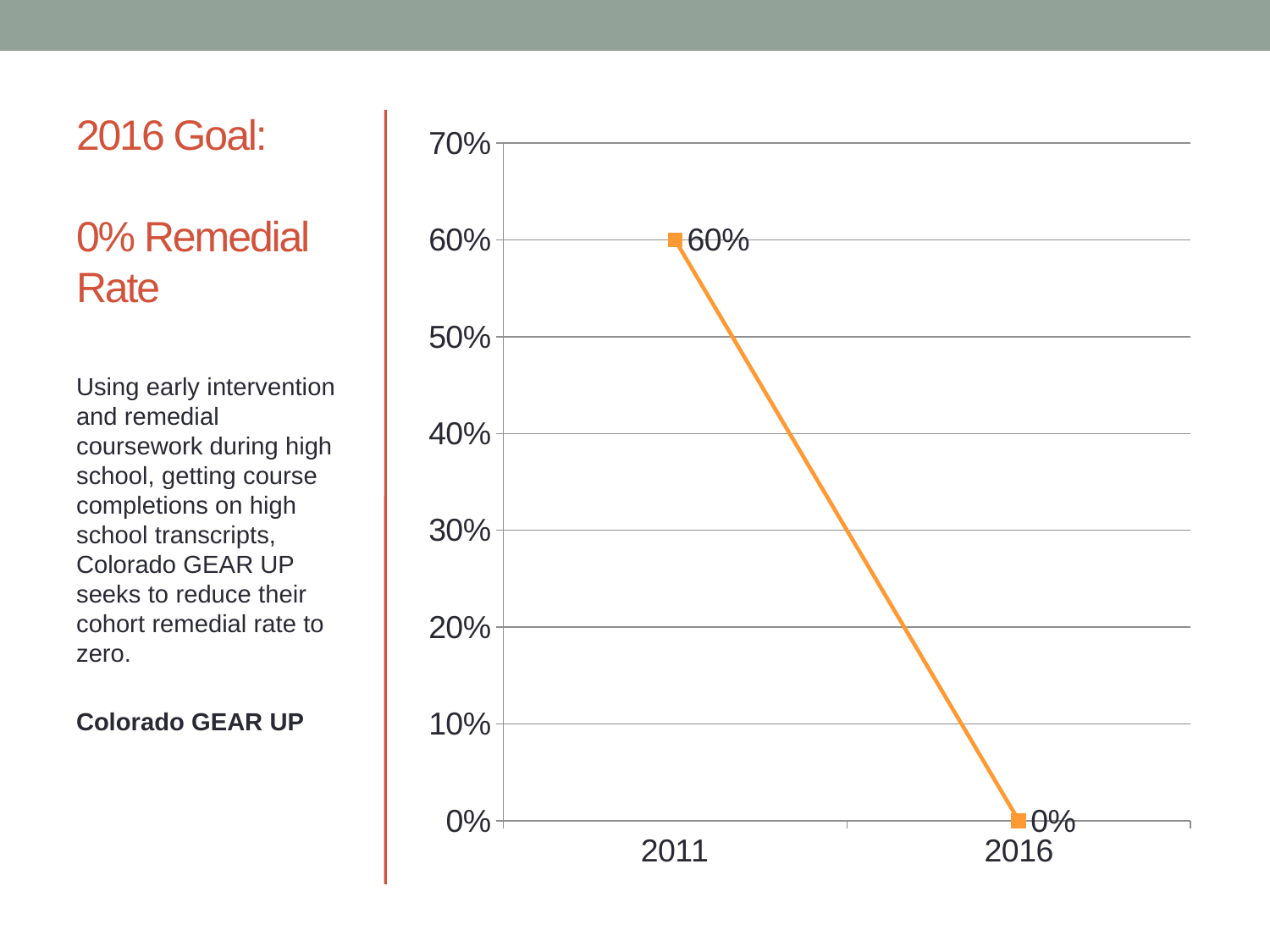
What kind of chart is shown on the slide? line chart Is the value for 2011 greater or less than 50%? greater What colour is the line on the chart? orange Do the values rise or fall from 2011 to 2016? fall What is the value for 2016? 0% Which year has the lowest value? 2016 Which is larger, the value for 2011 or the value for 2016? 2011 What is the highest value shown on the vertical axis? 70% What is the value for 2011? 60% Which year has the highest value? 2011 What is the difference between the values for 2011 and 2016? 60% How many data points are plotted on the chart? 2